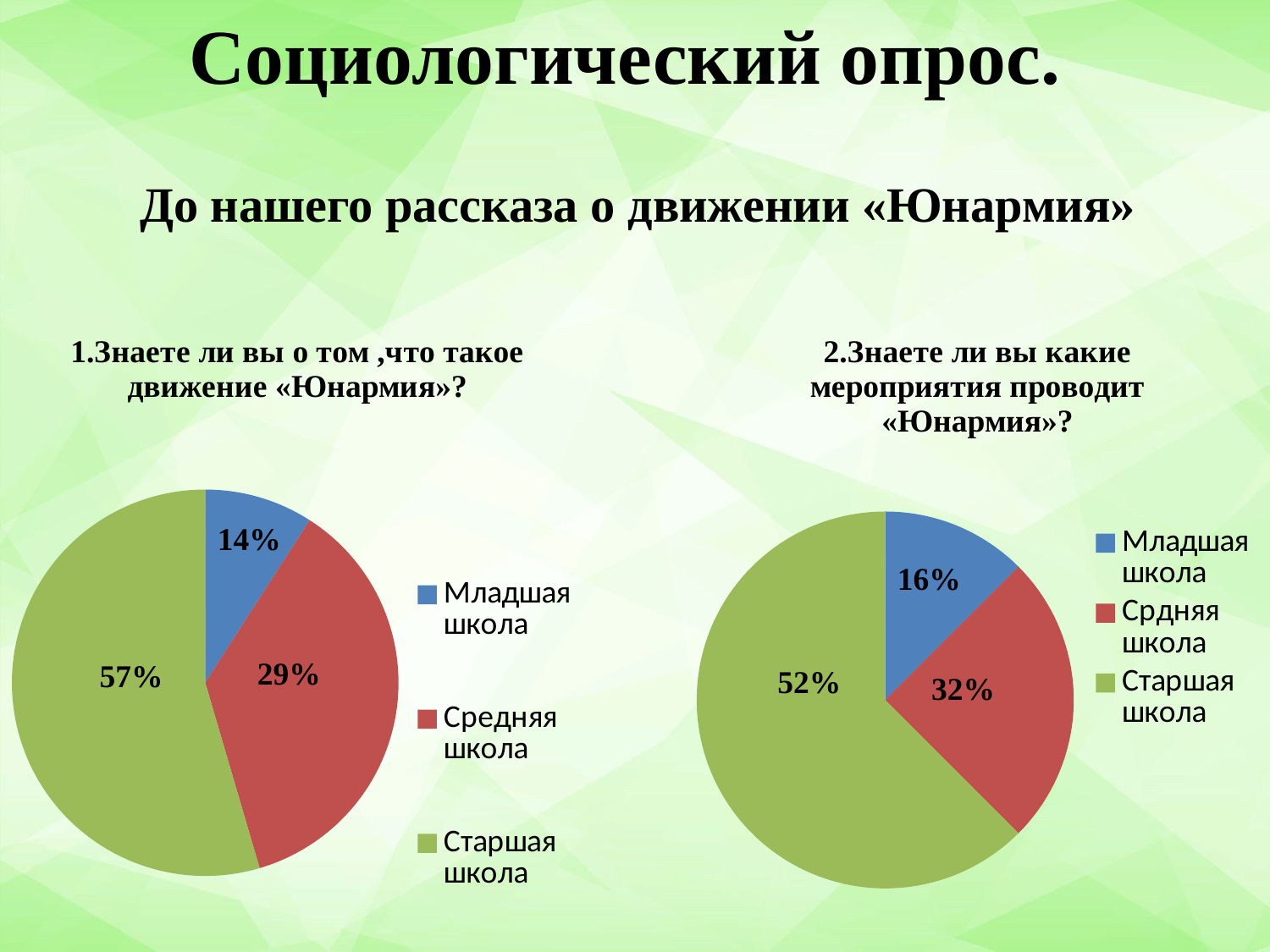
In the left pie chart, what share does Средняя школа have? 29% In the right pie chart, what is the difference between the shares of Срдняя школа and Младшая школа? 16% In the right pie chart, what share does Старшая школа have? 52% In the left pie chart, which category has the smallest share? Младшая школа In the left pie chart, what share does Младшая школа have? 14% How many slices does the right pie chart have? 3 In the left pie chart, which category has the largest share? Старшая школа In the left pie chart, what is the difference between the shares of Старшая школа and Средняя школа? 28% What kind of chart is the left chart titled «1.Знаете ли вы о том ,что такое движение «Юнармия»?»? pie chart In the right pie chart, which is larger: the share of Срдняя школа or Младшая школа? Срдняя школа In the right pie chart, what share does Младшая школа have? 16% How many entries does the legend of the left pie chart list? 3